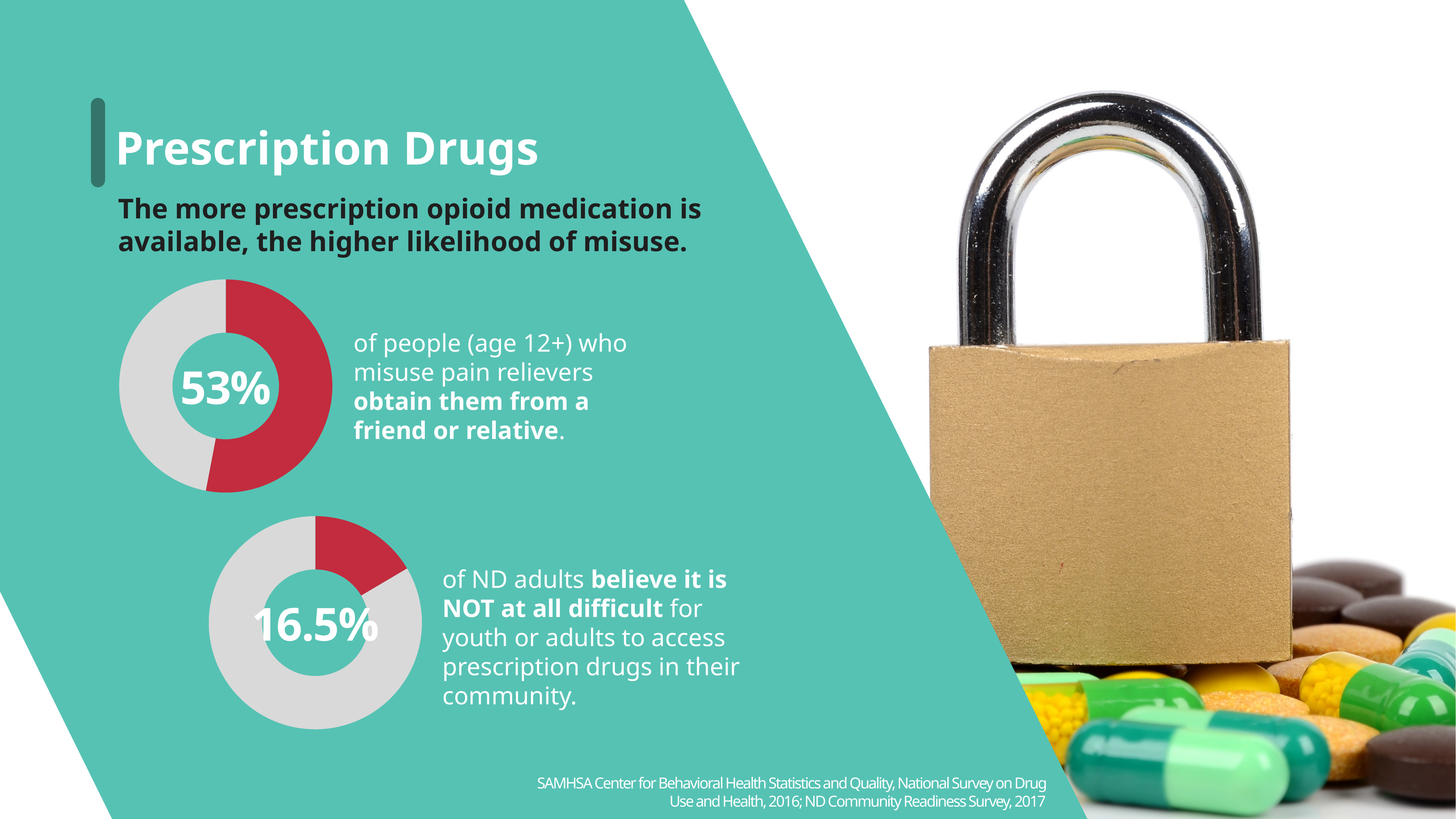
What is the title of the slide containing the two donut charts? Prescription Drugs Which chart shows the larger highlighted share, the upper chart (friend or relative) or the lower chart (ND adults)? The upper chart (53%) What percentage is shown in the lower donut chart on the slide? 16.5% What percentage is shown in the upper donut chart on the slide? 53% Is the highlighted share in the upper donut chart greater or less than 50%? greater Is the highlighted share in the lower donut chart greater or less than 25%? less What share of people (age 12+) who misuse pain relievers obtain them from a friend or relative, according to the upper chart? 53% How many donut charts are on the slide? 2 What kind of chart is used to show the 53% figure? Donut (pie) chart What share of ND adults believe it is NOT at all difficult for youth or adults to access prescription drugs in their community, according to the lower chart? 16.5% What colour is the highlighted slice in both donut charts? Red What is the difference in percentage points between the upper chart's 53% and the lower chart's 16.5%? 36.5 percentage points